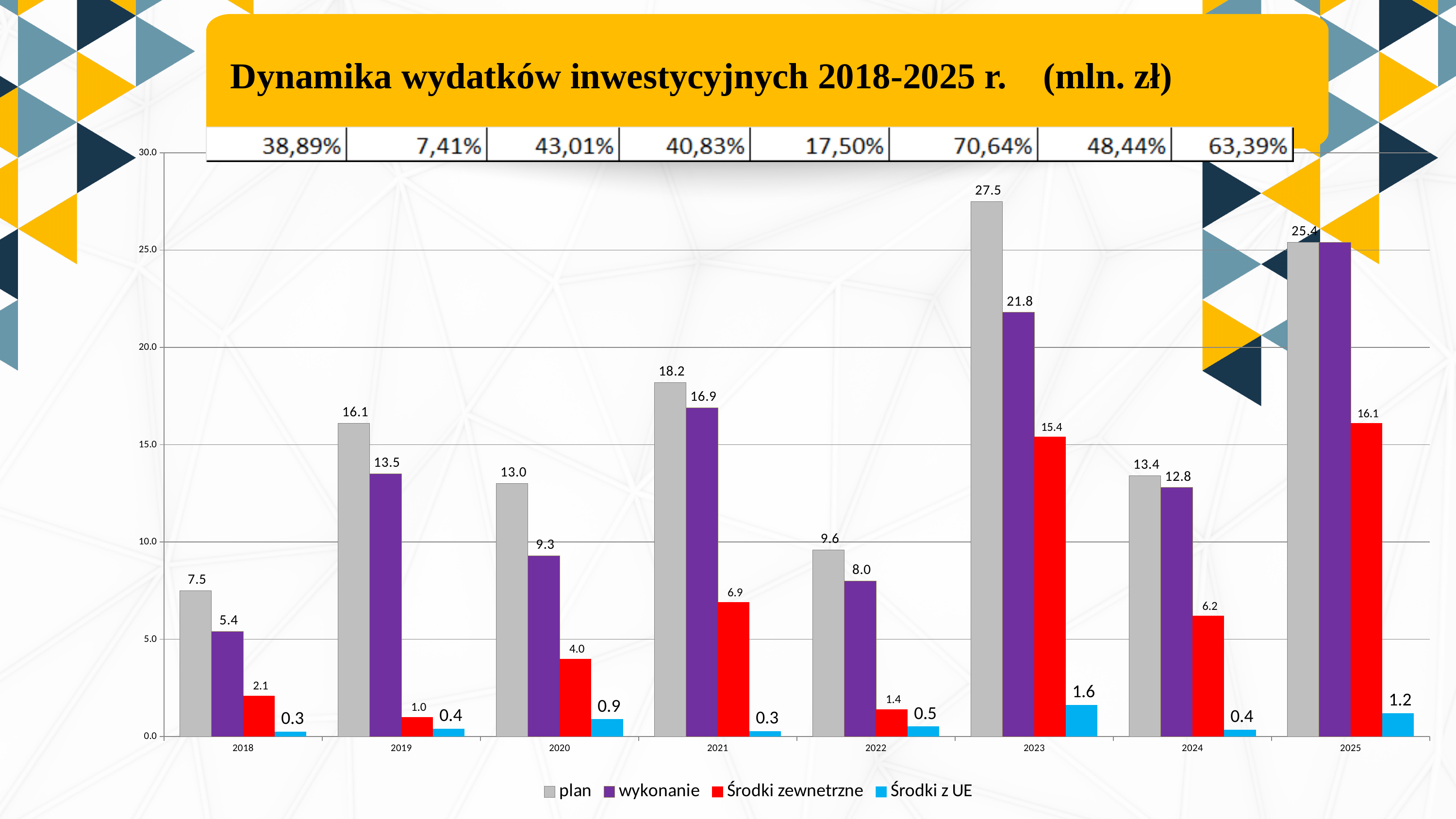
Which is larger, the Środki zewnetrzne value for 2023 or for 2024? 2023 How many series does the legend list? 4 What is the Środki zewnetrzne value for 2025? 16.1 What kind of chart is shown on the slide? bar chart Which year has the highest plan value? 2023 What is the Środki z UE value for 2020? 0.9 How many years are shown on the x axis? 8 What is the plan value for 2023? 27.5 What is the wykonanie value for 2021? 16.9 Is the wykonanie value for 2025 greater or less than 20.0? greater What is the difference between the plan and wykonanie values for 2019? 2.6 Which year has the lowest Środki zewnetrzne value? 2019